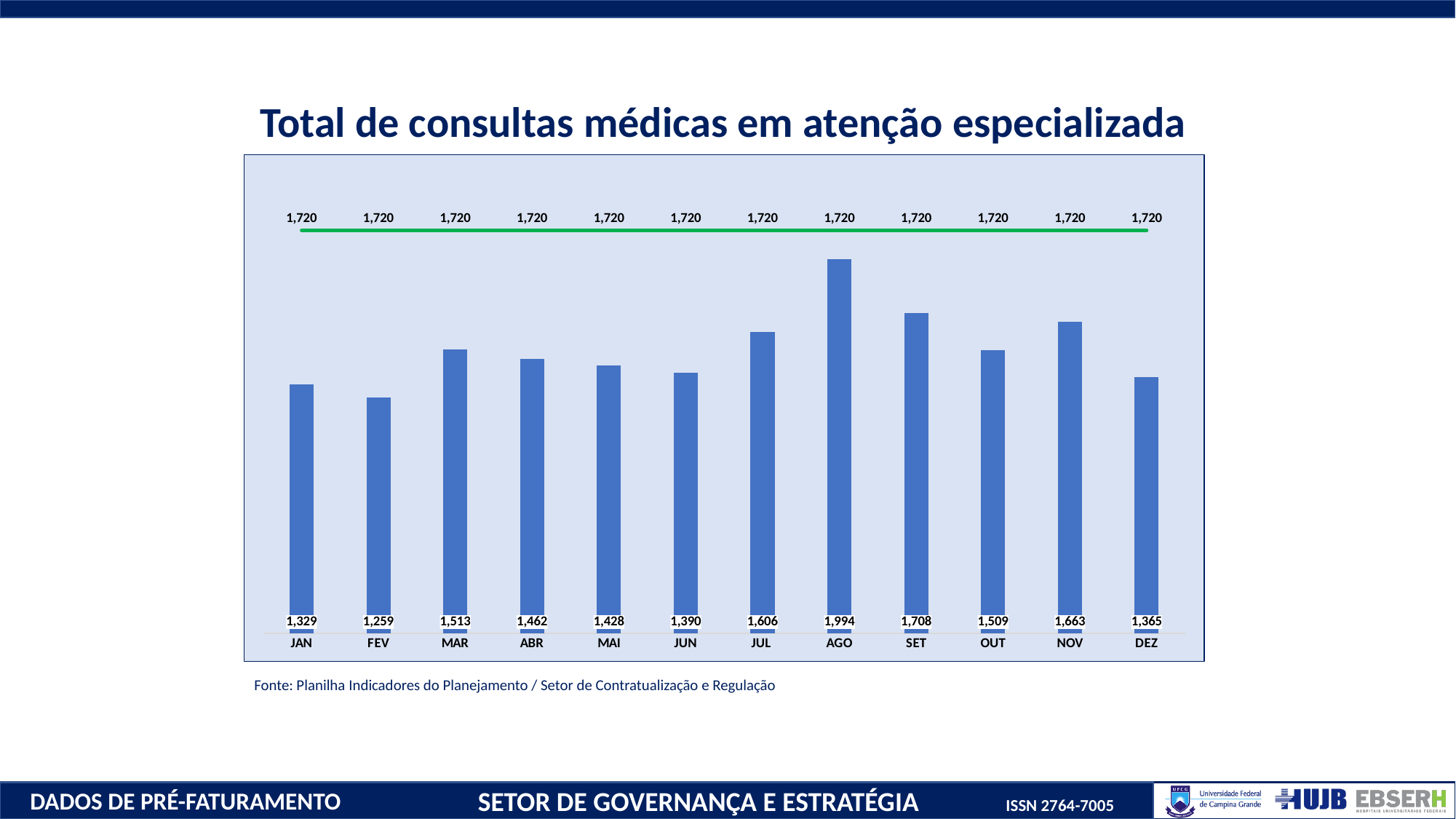
What is the value of the green target line for each month? 1,720 Which month has the lowest bar? FEV What is the difference between the bar values for AGO and FEV? 735 What is the title of the chart? Total de consultas médicas em atenção especializada What is the value of the bar for AGO? 1,994 Do the bar values rise or fall from JAN to FEV? Fall Which is larger, the bar for MAR or the bar for OUT? MAR What is the value of the bar for FEV? 1,259 How many months are shown on the x axis? 12 Which month has the highest bar? AGO What is the difference between the target line value and the bar value for JAN? 391 What kind of chart is shown on the slide? Bar chart with a line